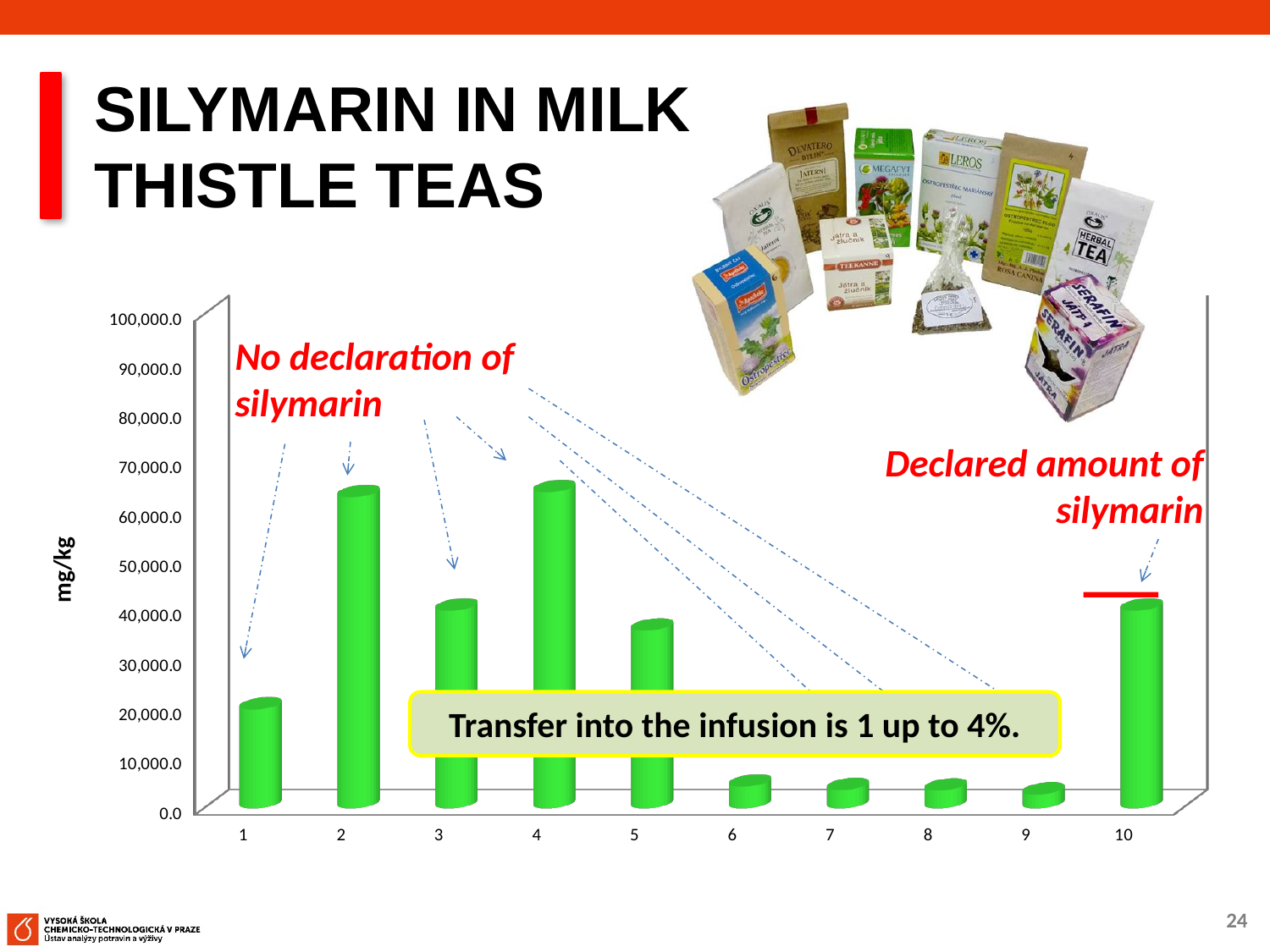
What kind of chart is shown on the slide? bar chart What is the label of the y axis of the chart? mg/kg Which has the larger value, category 1 or category 2? category 2 Is the value for category 6 greater or less than 10,000? less Which has the larger value, category 10 or category 8? category 10 Which has the larger value, category 5 or category 6? category 5 Is the value for category 1 greater or less than 30,000? less Is the value for category 2 greater or less than 60,000? greater How many categories are plotted along the x axis of the chart? 10